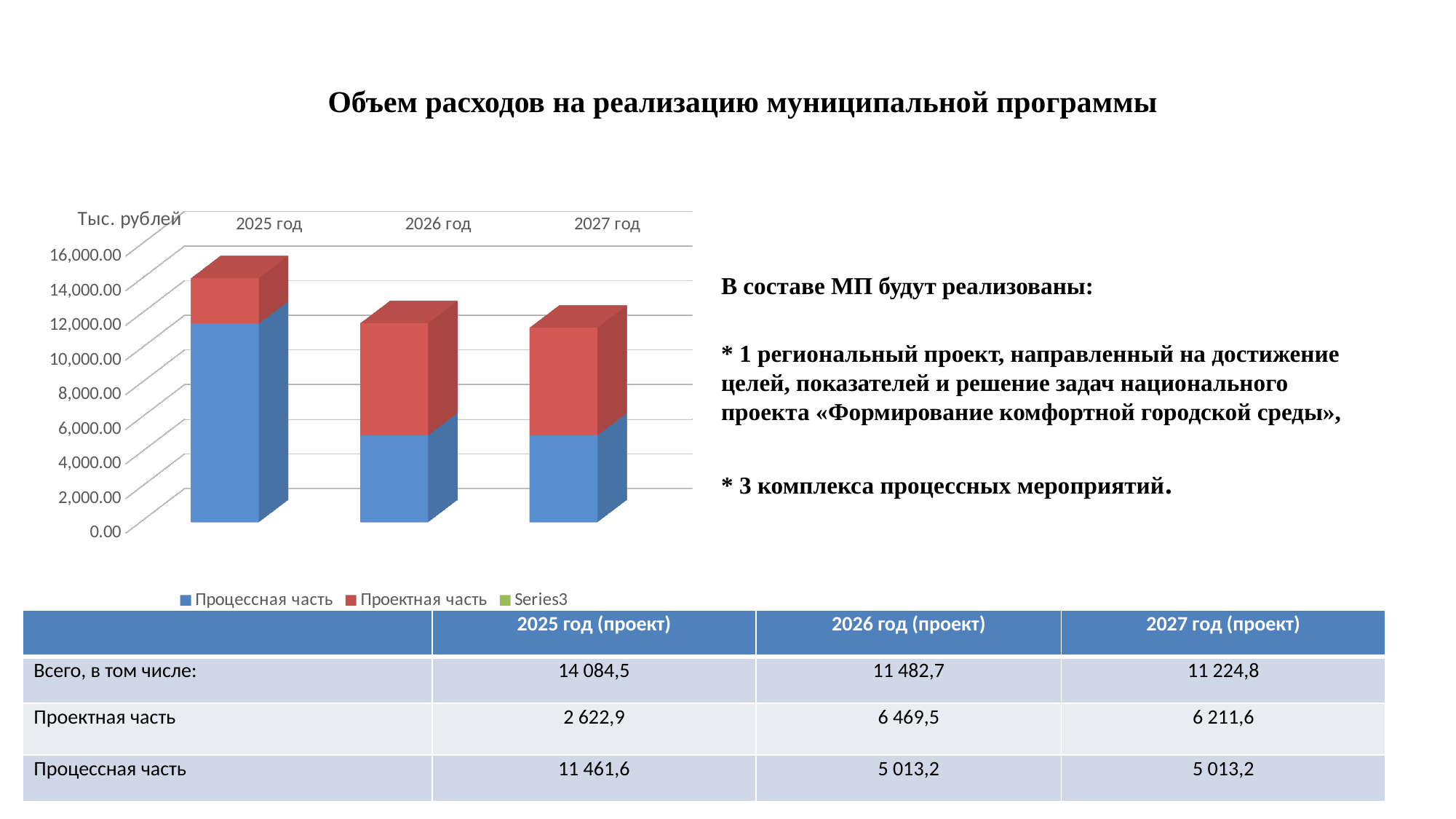
According to the table, what is the Проектная часть value for 2026 год (проект)? 6 469,5 How many year categories are plotted on the x axis of the chart? 3 What unit is shown at the top of the chart's vertical axis? Тыс. рублей What kind of chart is shown on the slide? bar chart In which year is the Процессная часть segment the largest? 2025 год Which is larger, the Проектная часть segment for 2025 год or for 2026 год? 2026 год Is the Процессная часть value for 2025 год greater or less than 10,000.00? greater Does the Процессная часть segment rise or fall from 2025 год to 2027 год? fall How many series does the chart legend list? 3 Which year has the tallest stacked bar in the chart? 2025 год Is the total stacked bar for 2026 год greater or less than 12,000.00? less In which year is the Проектная часть segment the smallest? 2025 год